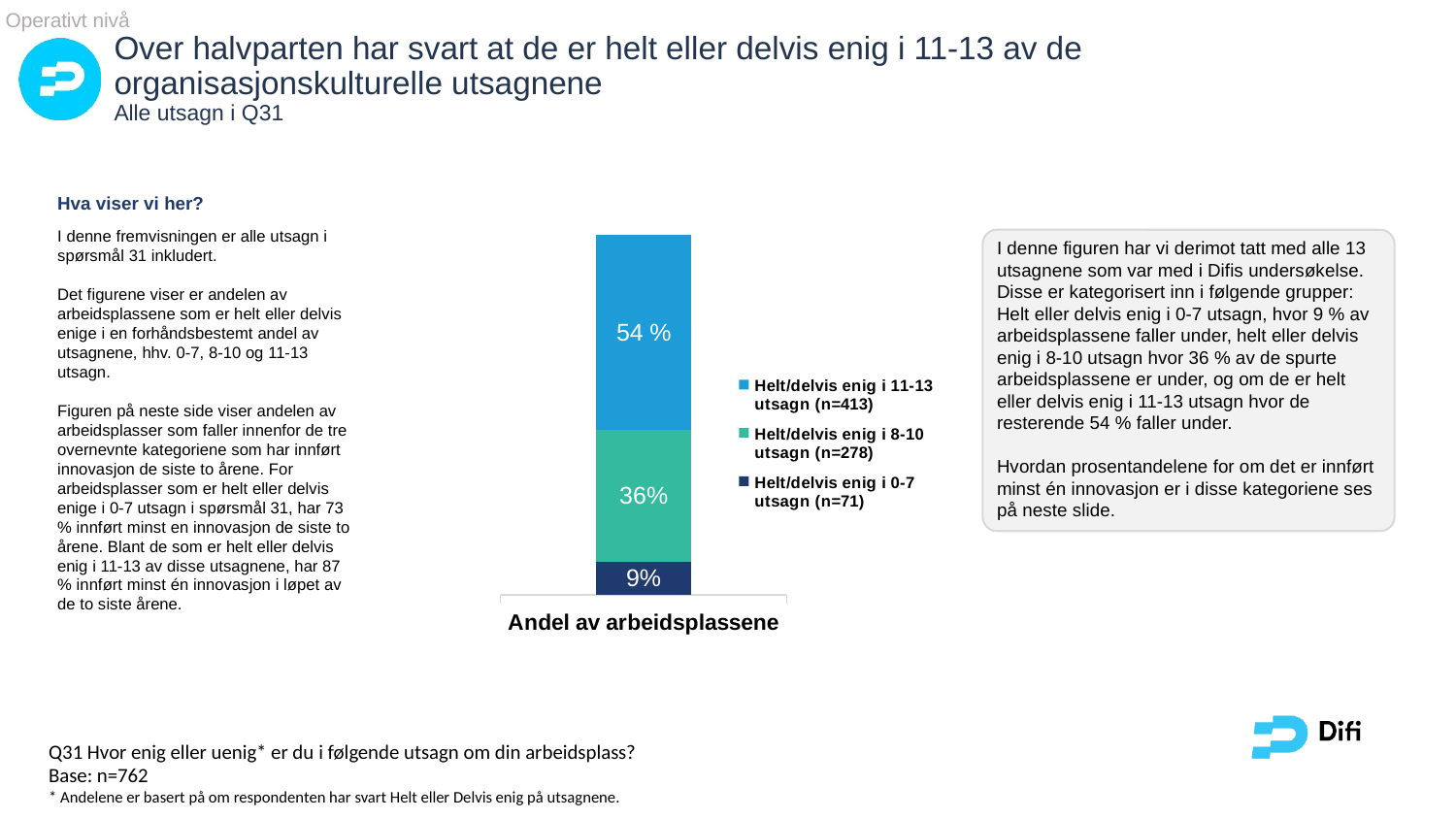
What share of workplaces is shown for 'Helt/delvis enig i 8-10 utsagn (n=278)'? 36% What share of workplaces is shown for 'Helt/delvis enig i 0-7 utsagn (n=71)'? 9% What is the label on the category axis below the bar? Andel av arbeidsplassene What share of workplaces is shown for 'Helt/delvis enig i 11-13 utsagn (n=413)'? 54 % Which segment of the stacked bar is at the bottom? Helt/delvis enig i 0-7 utsagn (n=71) What kind of chart is shown on the slide? Stacked bar chart What is the difference between the share for 'Helt/delvis enig i 11-13 utsagn' and the share for 'Helt/delvis enig i 8-10 utsagn'? 18 percentage points What is the total of the stacked bar when the three printed segment values are added together? 99% How many series does the legend list? 3 Which group has the largest share of workplaces in the chart? Helt/delvis enig i 11-13 utsagn (n=413) Which group has the smallest share of workplaces in the chart? Helt/delvis enig i 0-7 utsagn (n=71) Which is larger: the share for 'Helt/delvis enig i 8-10 utsagn' or the share for 'Helt/delvis enig i 0-7 utsagn'? Helt/delvis enig i 8-10 utsagn